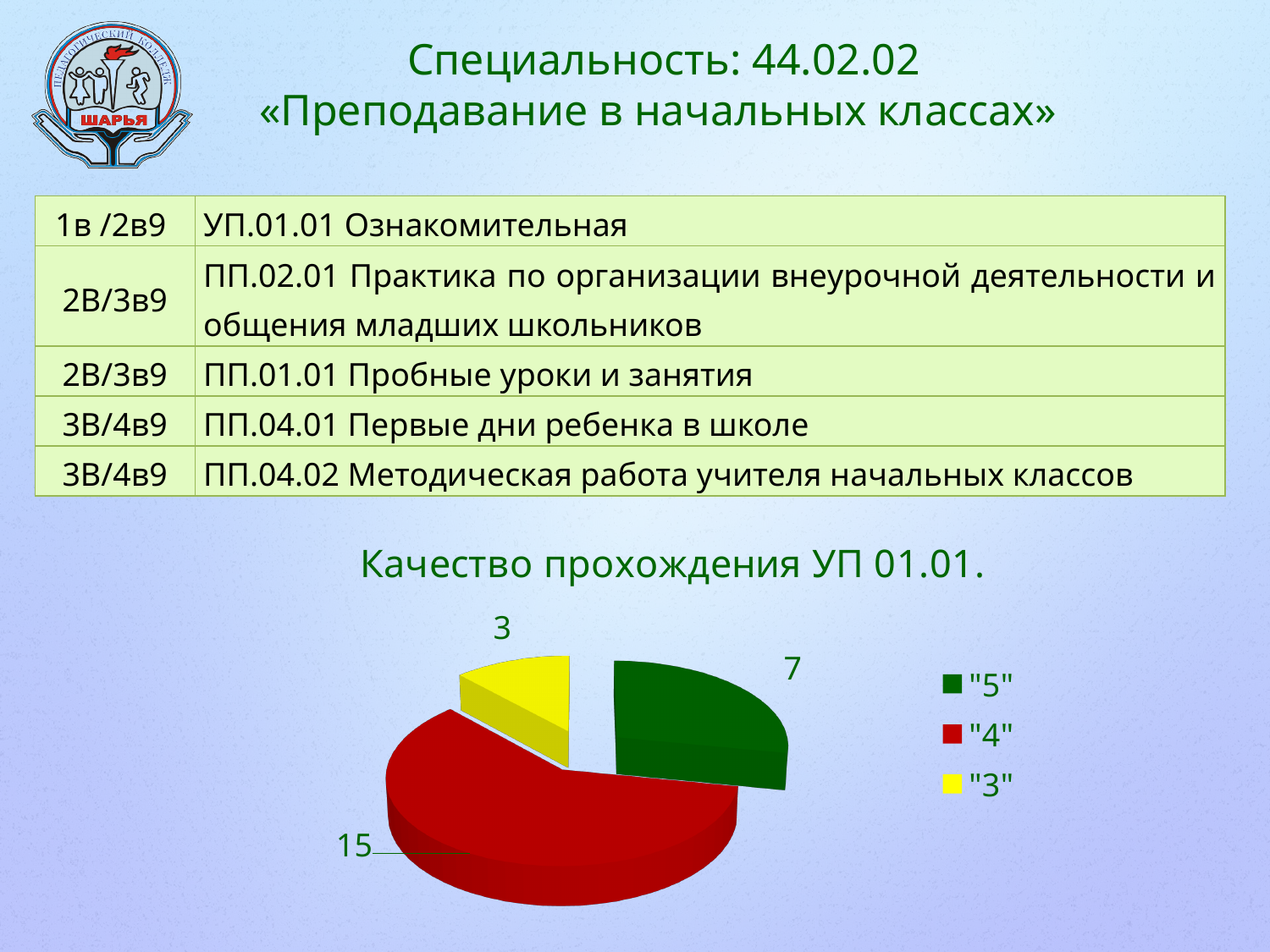
Which category has the smallest slice in the pie chart? "3" How many slices does the pie chart have? 3 What colour is the "3" slice in the pie chart? yellow What share of the pie chart does the "4" slice represent? 60% What is the value for the "4" slice in the pie chart? 15 What is the value for the "5" slice in the pie chart? 7 What kind of chart is shown under the title "Качество прохождения УП 01.01."? pie chart What is the total of all slices in the pie chart? 25 Which is larger in the pie chart, the value for "5" or the value for "3"? "5" Which category has the largest slice in the pie chart? "4" What is the value for the "3" slice in the pie chart? 3 What is the difference between the values for "4" and "5" in the pie chart? 8